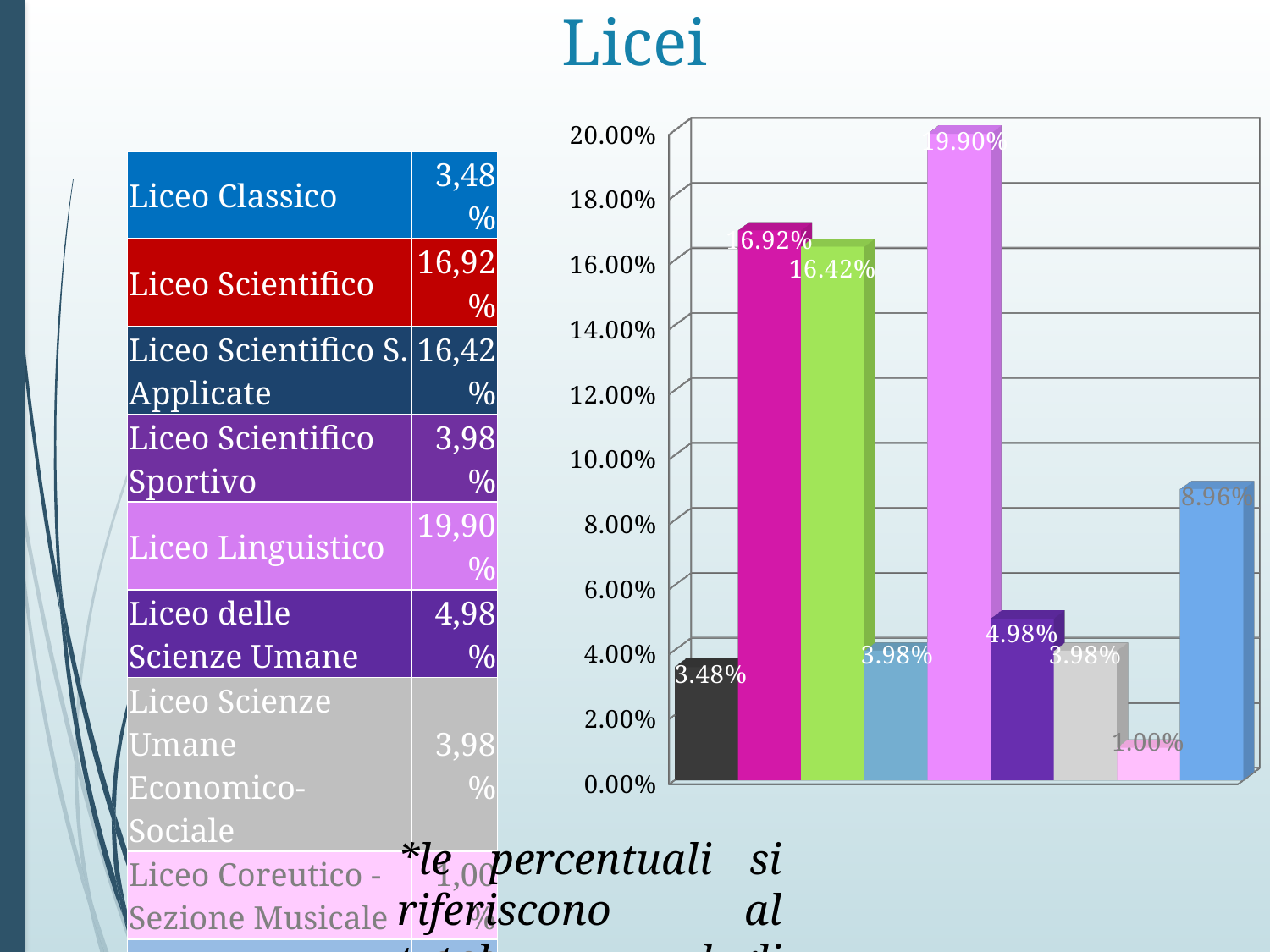
What is the value labelled on the last (rightmost) bar of the chart? 8.96% What is the value labelled on the second bar of the chart? 16.92% What is the value shown on the highest bar in the chart? 19.90% What is the value labelled on the first (leftmost) bar of the chart? 3.48% What is the value shown on the lowest bar in the chart? 1.00% Is the value of the rightmost bar greater or less than 8.00%? greater What is the title of the slide containing the chart? Licei According to the table, which liceo has the highest percentage, 19.90%? Liceo Linguistico What is the difference between the second bar (16.92%) and the third bar (16.42%)? 0.50% How many bars are plotted in the chart? 9 What kind of chart is shown on the slide? bar chart Which is larger, the second bar or the third bar of the chart? the second bar (16.92%)